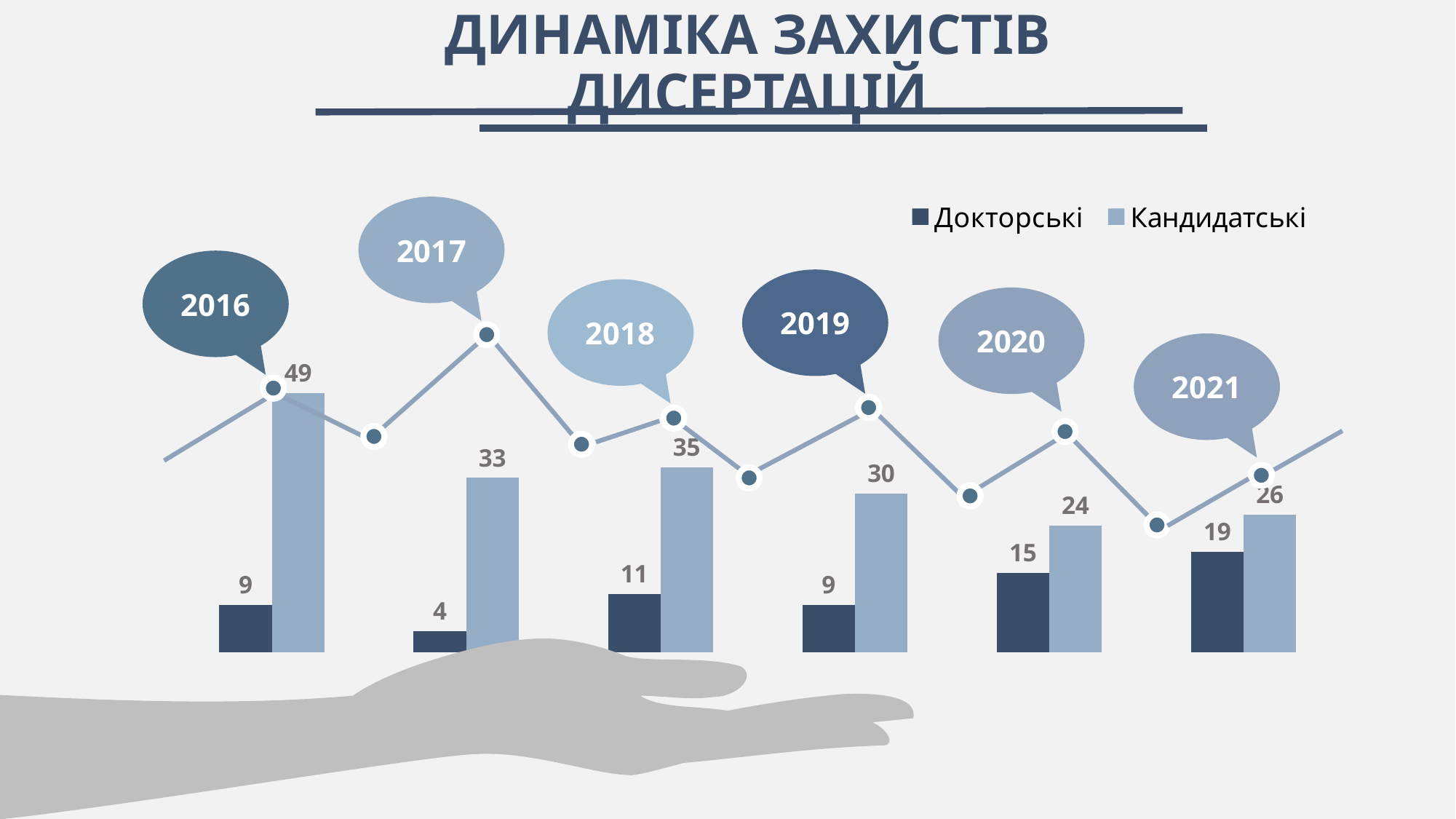
What is the value for Докторські in 2017? 4 In which year is the Докторські value lowest? 2017 What kind of chart is shown on the slide? bar chart What is the difference between the Кандидатські and Докторські values in 2018? 24 Do the Докторські values rise or fall from 2019 to 2021? rise What is the value for Кандидатські in 2016? 49 What is the value for Кандидатські in 2020? 24 How many series does the legend list? 2 How many years are shown on the x axis? 6 In which year is the Кандидатські value highest? 2016 What is the value for Докторські in 2021? 19 Which is larger: the Докторські value in 2020 or the Докторські value in 2019? 2020